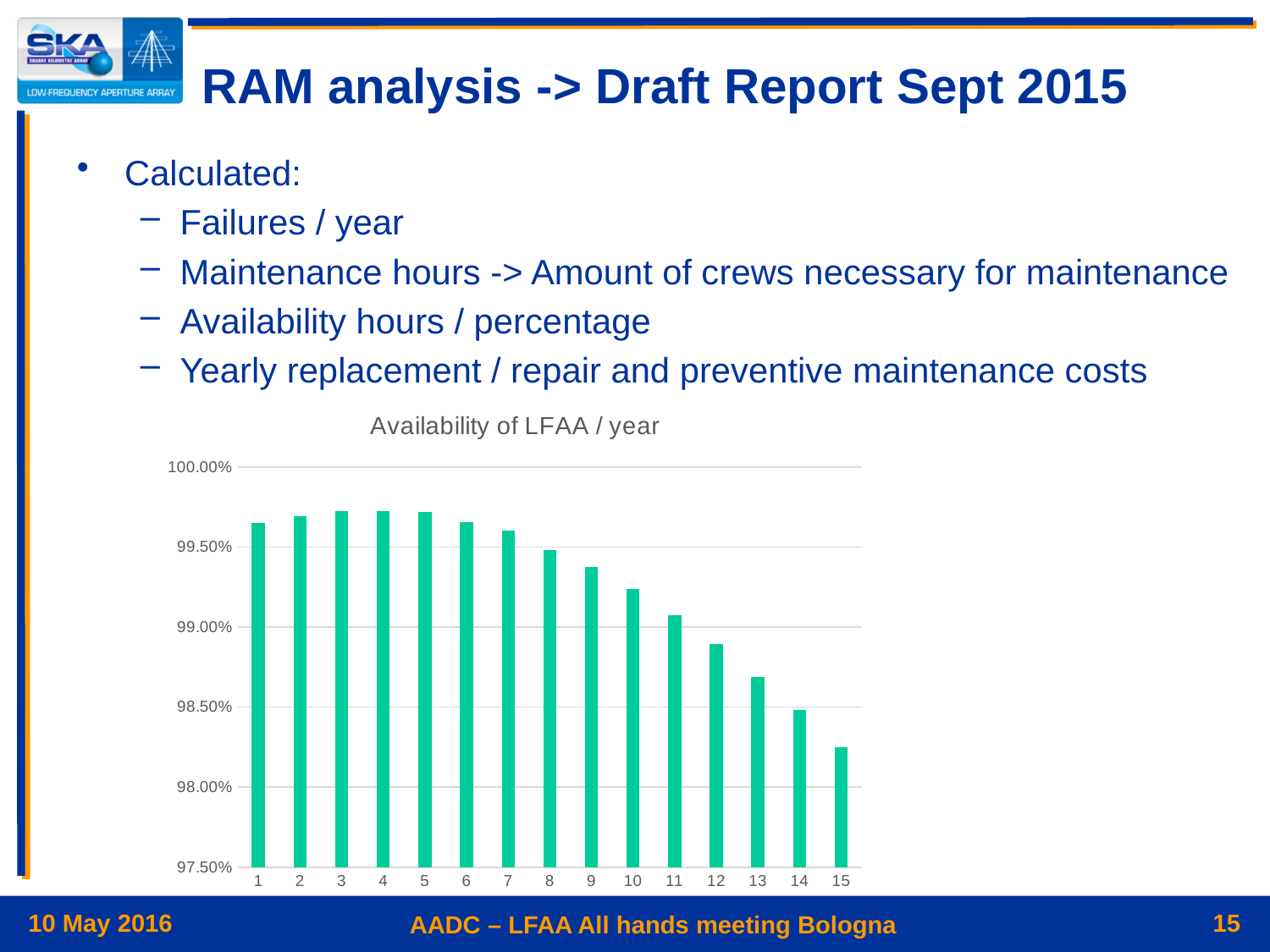
Is the availability for year 10 greater or less than 99.00%? greater Is the availability for year 9 greater or less than 99.50%? less What type of chart is shown on the slide? bar chart Is the availability for year 15 greater or less than 98.50%? less How many years (bars) are plotted in the chart? 15 Which has the higher availability, year 2 or year 14? year 2 Which year has the lowest availability? 15 Does the availability rise or fall from year 5 to year 15? fall What is the title of the chart? Availability of LFAA / year